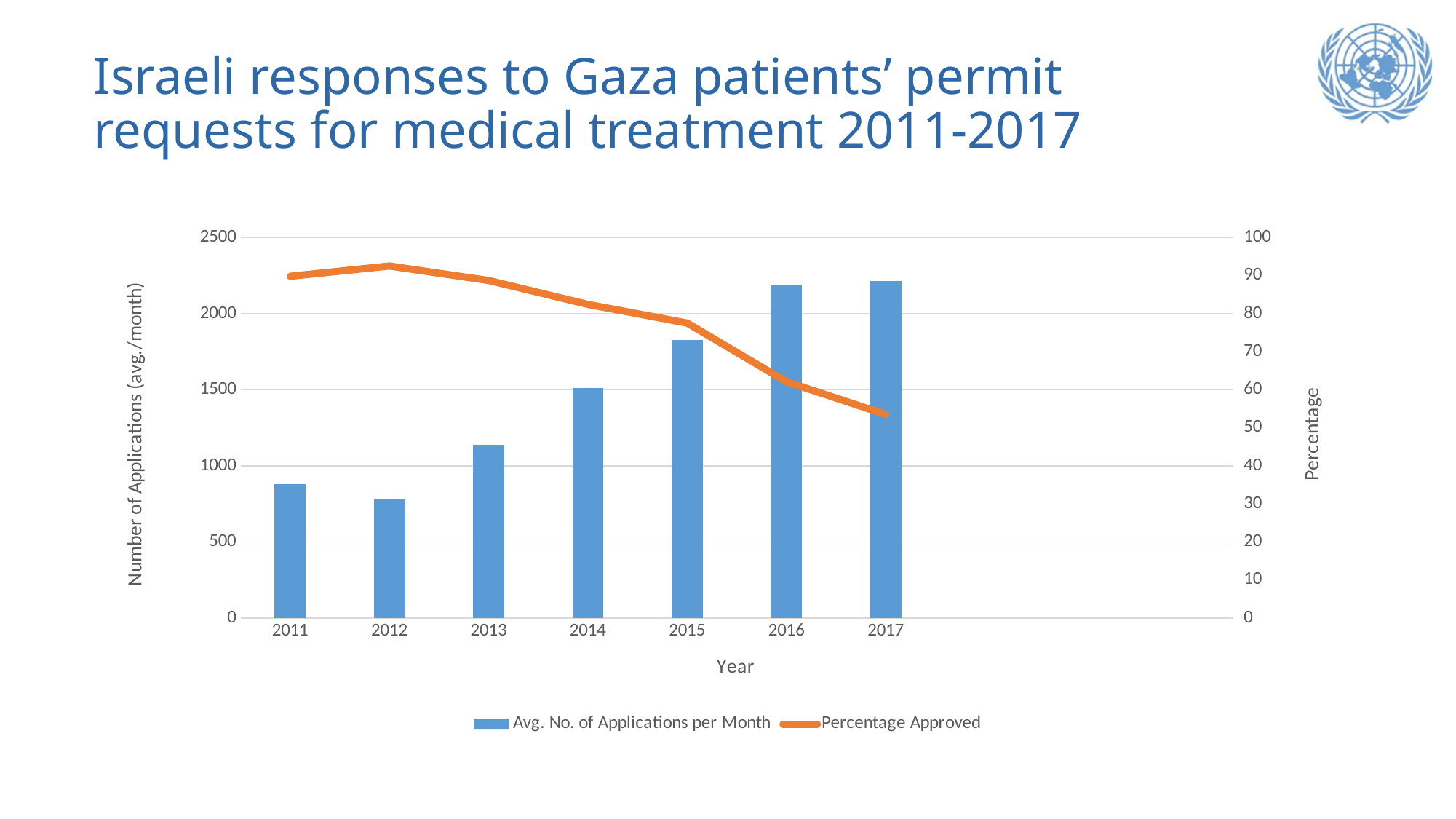
Is the average number of applications per month for 2011 greater or less than 1000? less Is the average number of applications per month for 2015 greater or less than 1500? greater How many series does the chart's legend list? 2 Which year has a higher average number of applications per month, 2013 or 2014? 2014 Which year has the lowest average number of applications per month? 2012 Does the percentage approved generally rise or fall from 2012 to 2017? fall Is the average number of applications per month for 2016 greater or less than 2000? greater Which series is drawn as an orange line in the chart? Percentage Approved What kind of chart is shown on the slide? A combined bar and line chart How many years are shown on the x axis of the chart? 7 Which year has the lowest percentage approved? 2017